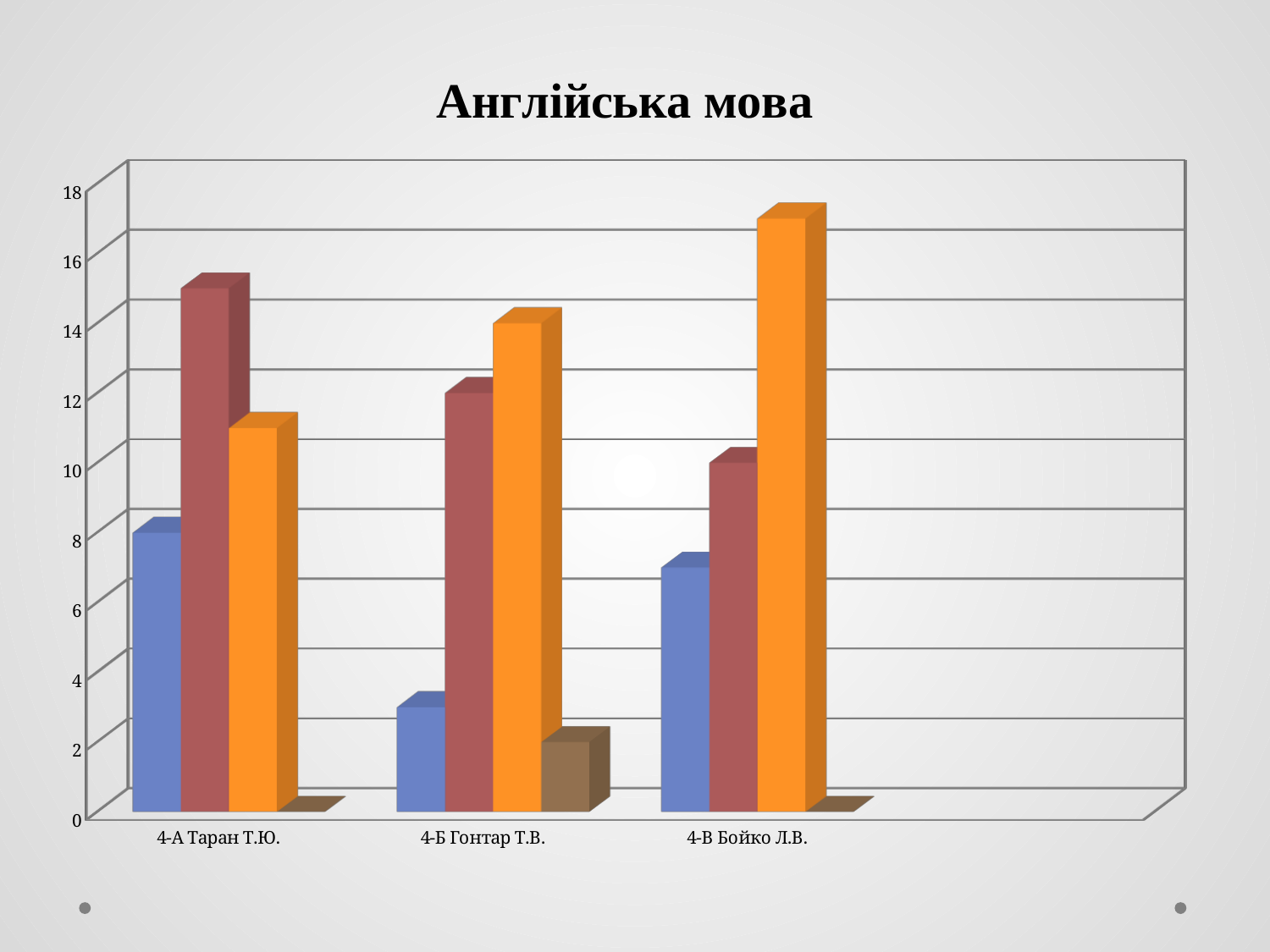
Which category has the tallest red bar? 4-А Таран Т.Ю. Is the blue bar for 4-Б Гонтар Т.В. greater or less than 4? less Is the red bar for 4-А Таран Т.Ю. greater or less than 14? greater Is the blue bar for 4-А Таран Т.Ю. greater or less than 10? less Which is larger for 4-В Бойко Л.В.: the blue bar or the red bar? the red bar How many categories are shown on the x axis of the chart? 3 What kind of chart is shown on the slide? bar chart Which category has the shortest blue bar? 4-Б Гонтар Т.В. Which is larger: the orange bar for 4-А Таран Т.Ю. or the orange bar for 4-Б Гонтар Т.В.? 4-Б Гонтар Т.В. What is the title of the chart? Англійська мова Which category has the tallest orange bar? 4-В Бойко Л.В.